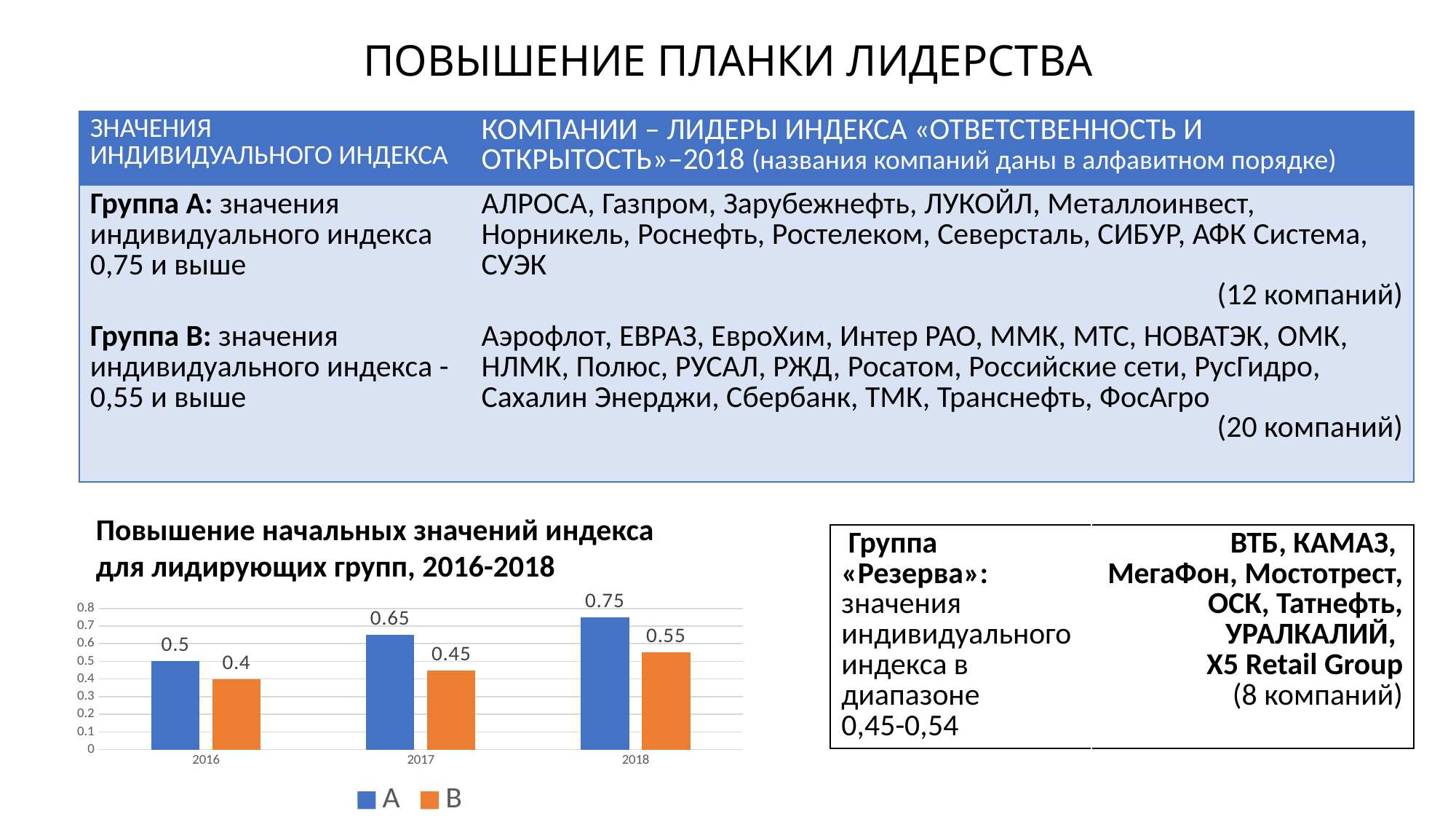
What is the value for series A in 2018? 0.75 How many years are shown on the x axis of the chart? 3 What is the value for series A in 2016? 0.5 What is the value for series B in 2018? 0.55 In which year is the value for series B lowest? 2016 Which is larger in 2016, series A or series B? A How many series does the chart legend list? 2 In which year is the value for series A highest? 2018 What is the value for series B in 2017? 0.45 Do the values for series A rise or fall from 2016 to 2018? rise What kind of chart is shown on the slide? bar chart What is the difference between series A and series B in 2017? 0.2